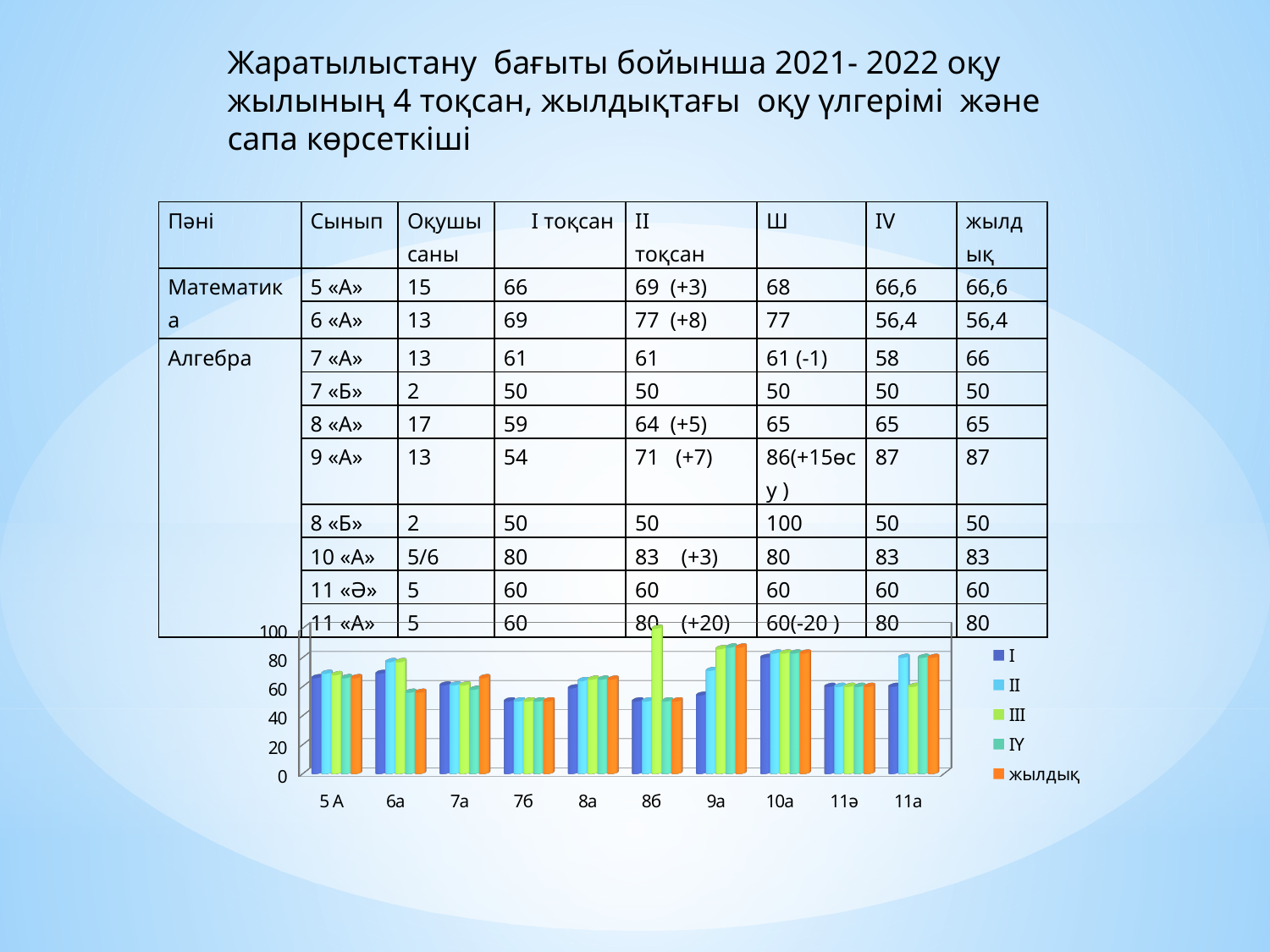
Which category has the highest III bar in the chart? 8б How many series does the chart legend list? 5 What value does the III bar for 8б reach in the chart? 100 How many class categories are shown along the x axis of the chart? 10 Is the II value for 6а greater or less than 60? greater What kind of chart is shown at the bottom of the slide? bar chart What value does the I bar for 10а reach in the chart? 80 Is the I value for 7б greater or less than 60? less For 11а, which is larger: the II bar or the III bar? II Which is larger in the chart: the I bar for 10а or the I bar for 5 A? 10а What are the entries listed in the chart legend? I, II, III, IY, жылдық Is the IY value for 9а greater or less than 80? greater